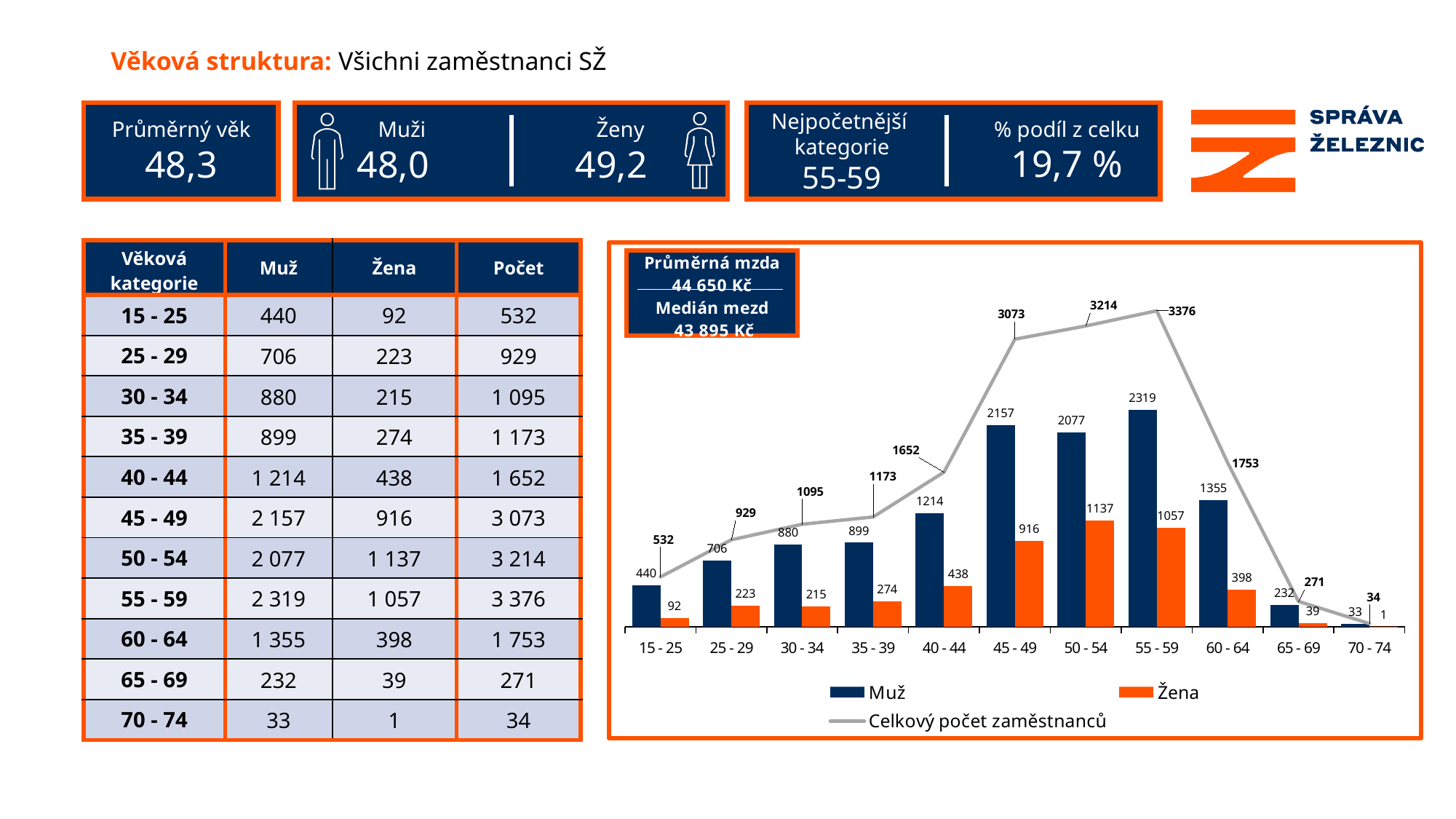
What is the difference between the Muž and Žena values for the 40 - 44 age category in the chart? 776 Which series in the chart is drawn in orange? Žena Which age category has the highest value for the Muž series in the chart? 55 - 59 What kind of chart is shown on the slide? Combined bar and line chart What is the value of the Muž series for the 55 - 59 age category in the chart? 2319 How many age categories are shown on the x axis of the chart? 11 Does the Celkový počet zaměstnanců line rise or fall from the 55 - 59 category to the 70 - 74 category? fall Which age category has the lowest value for the Žena series in the chart? 70 - 74 What is the value of the Celkový počet zaměstnanců line for the 45 - 49 age category? 3073 What is the value of the Žena series for the 50 - 54 age category in the chart? 1137 How many series does the chart legend list? 3 In the chart, is the Žena value for 50 - 54 larger or smaller than the Žena value for 55 - 59? larger